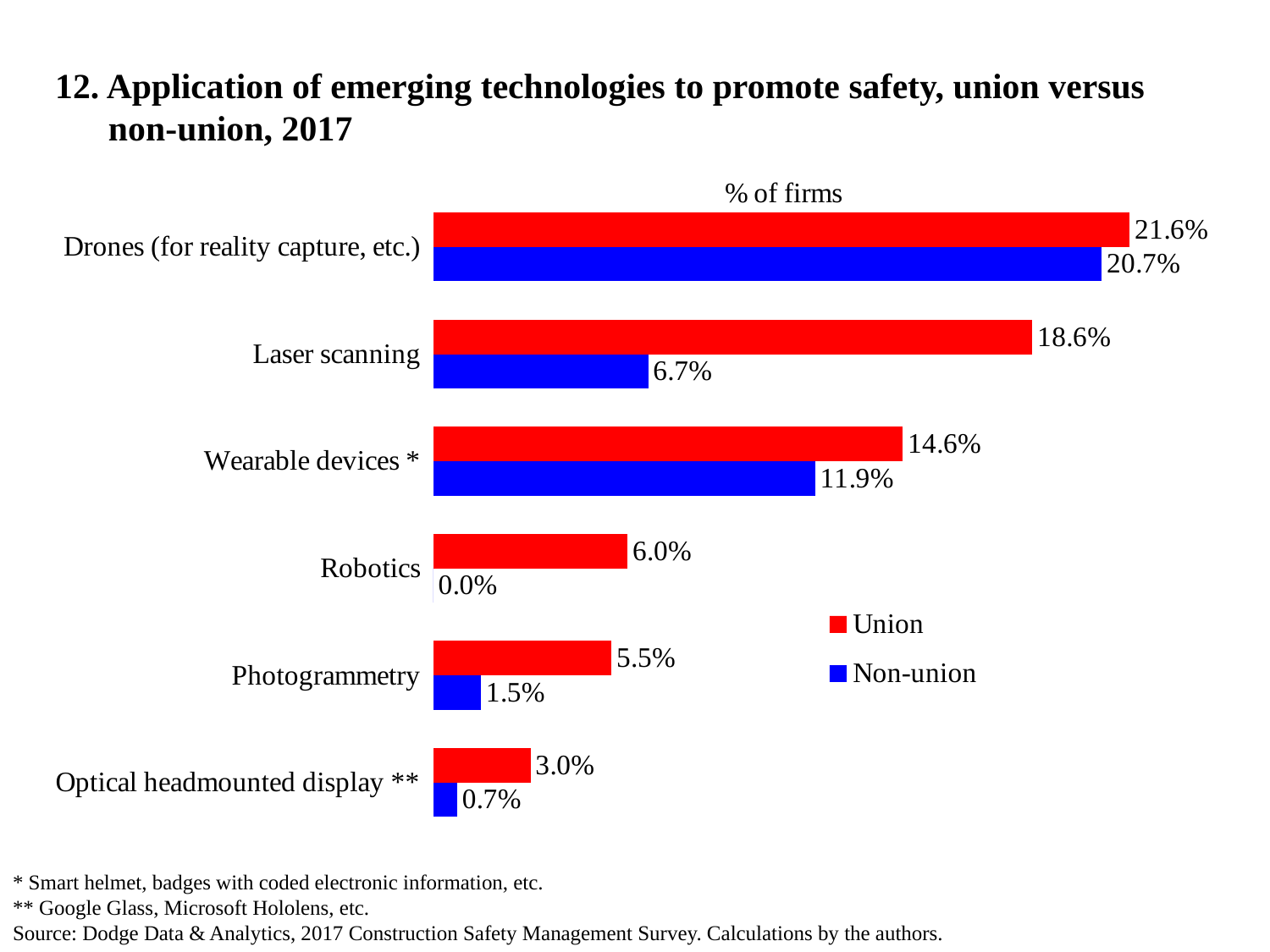
How many technologies are shown in the chart? 6 What percentage of non-union firms use laser scanning? 6.7% Which is larger for photogrammetry, the union or the non-union value? Union Which technology has the lowest share of non-union firms? Robotics Which colour represents non-union firms in the chart? Blue How many series does the legend list? 2 What type of chart is shown on the slide? Bar chart What is the difference between the union and non-union values for laser scanning? 11.9 percentage points Which technology has the highest share of union firms? Drones (for reality capture, etc.) What percentage of union firms use drones (for reality capture, etc.)? 21.6% What is the difference between the union and non-union values for wearable devices? 2.7 percentage points What is the non-union value for robotics? 0.0%